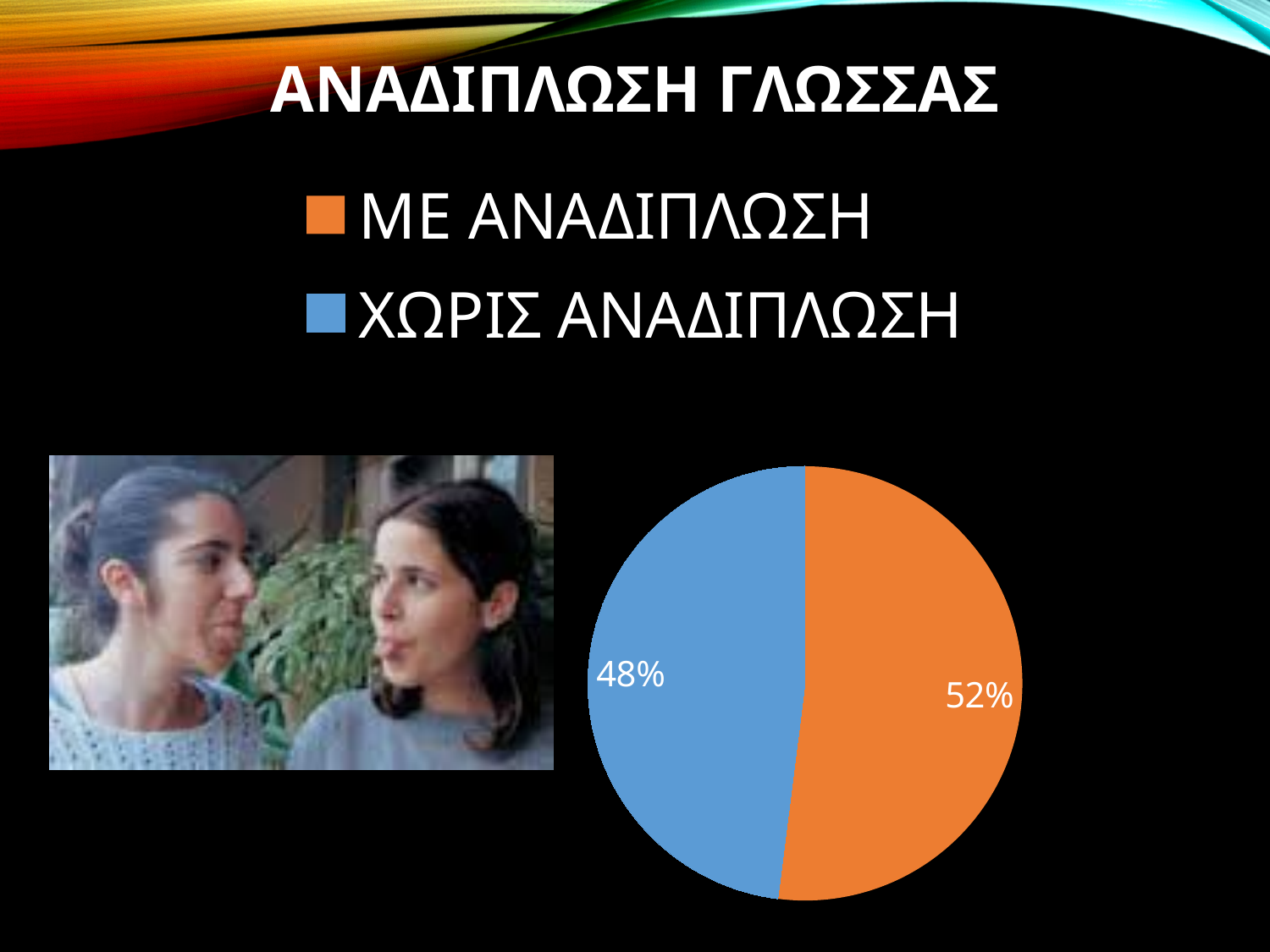
What colour represents ΧΩΡΙΣ ΑΝΑΔΙΠΛΩΣΗ in the pie chart? blue What is the total of the two slices shown in the pie chart? 100% What is the title of the chart? ΑΝΑΔΙΠΛΩΣΗ ΓΛΩΣΣΑΣ Is the share for ΜΕ ΑΝΑΔΙΠΛΩΣΗ larger or smaller than the share for ΧΩΡΙΣ ΑΝΑΔΙΠΛΩΣΗ? larger What kind of chart is shown on the slide? pie chart What is the difference in percentage points between ΜΕ ΑΝΑΔΙΠΛΩΣΗ and ΧΩΡΙΣ ΑΝΑΔΙΠΛΩΣΗ? 4 percentage points How many slices does the pie chart have? 2 What percentage is shown for ΜΕ ΑΝΑΔΙΠΛΩΣΗ? 52% Which category has the larger share of the pie? ΜΕ ΑΝΑΔΙΠΛΩΣΗ How many entries does the legend list? 2 What percentage is shown for ΧΩΡΙΣ ΑΝΑΔΙΠΛΩΣΗ? 48% Which category has the smaller share of the pie? ΧΩΡΙΣ ΑΝΑΔΙΠΛΩΣΗ